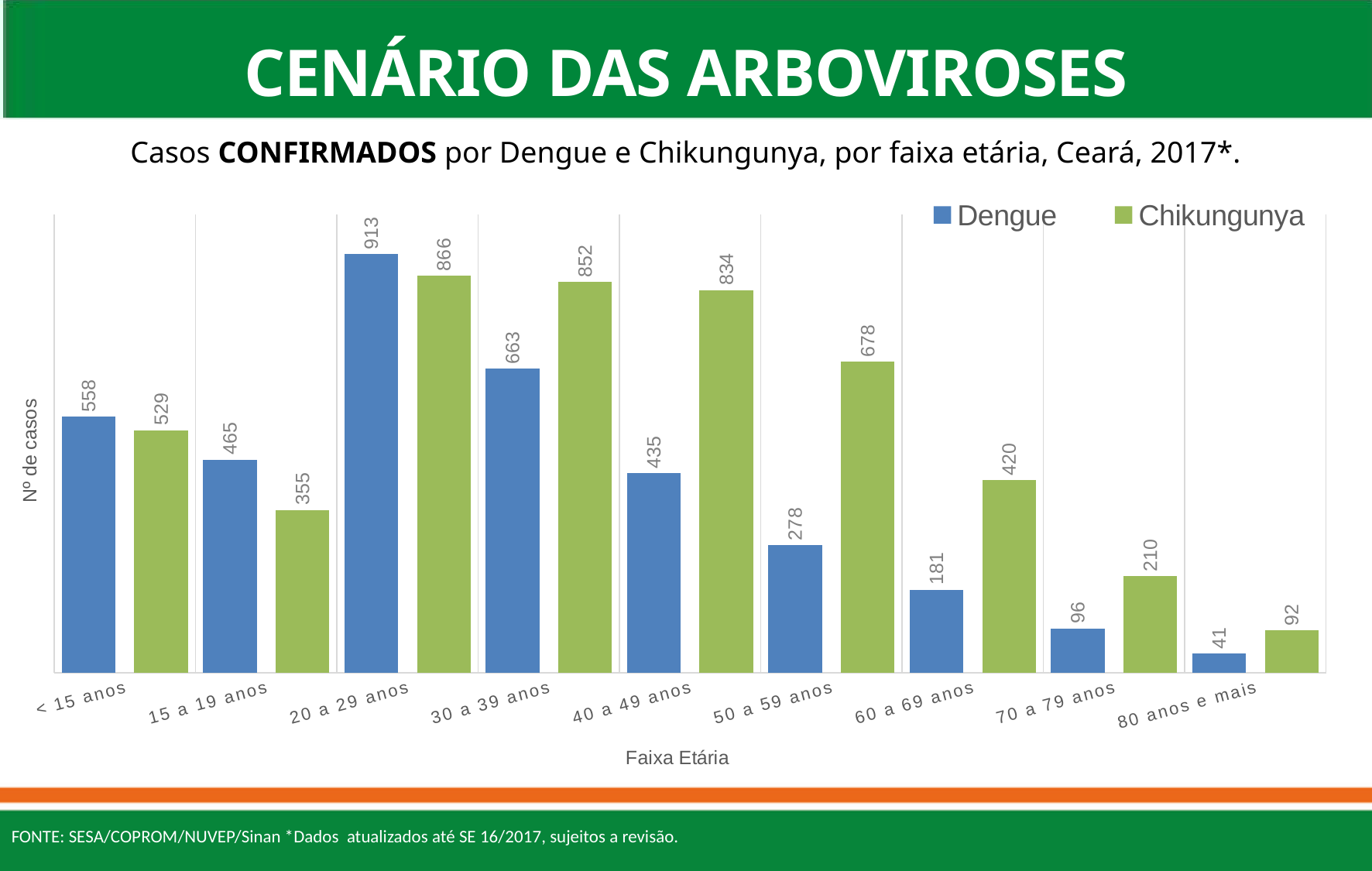
How many age groups are shown on the x axis? 9 Which age group has the highest number of Chikungunya cases? 20 a 29 anos How many series does the legend list? 2 What kind of chart is shown on the slide? Bar chart Which age group has the lowest number of Dengue cases? 80 anos e mais How many Chikungunya cases are shown for the 60 a 69 anos age group? 420 What is the label of the x axis? Faixa Etária How many Dengue cases are shown for the 20 a 29 anos age group? 913 What is the total of Dengue and Chikungunya cases for the < 15 anos age group? 1087 In the 30 a 39 anos age group, which has more cases, Dengue or Chikungunya? Chikungunya From the 40 a 49 anos group to the 80 anos e mais group, do the Chikungunya values rise or fall? Fall What is the difference between Dengue and Chikungunya cases in the 50 a 59 anos age group? 400